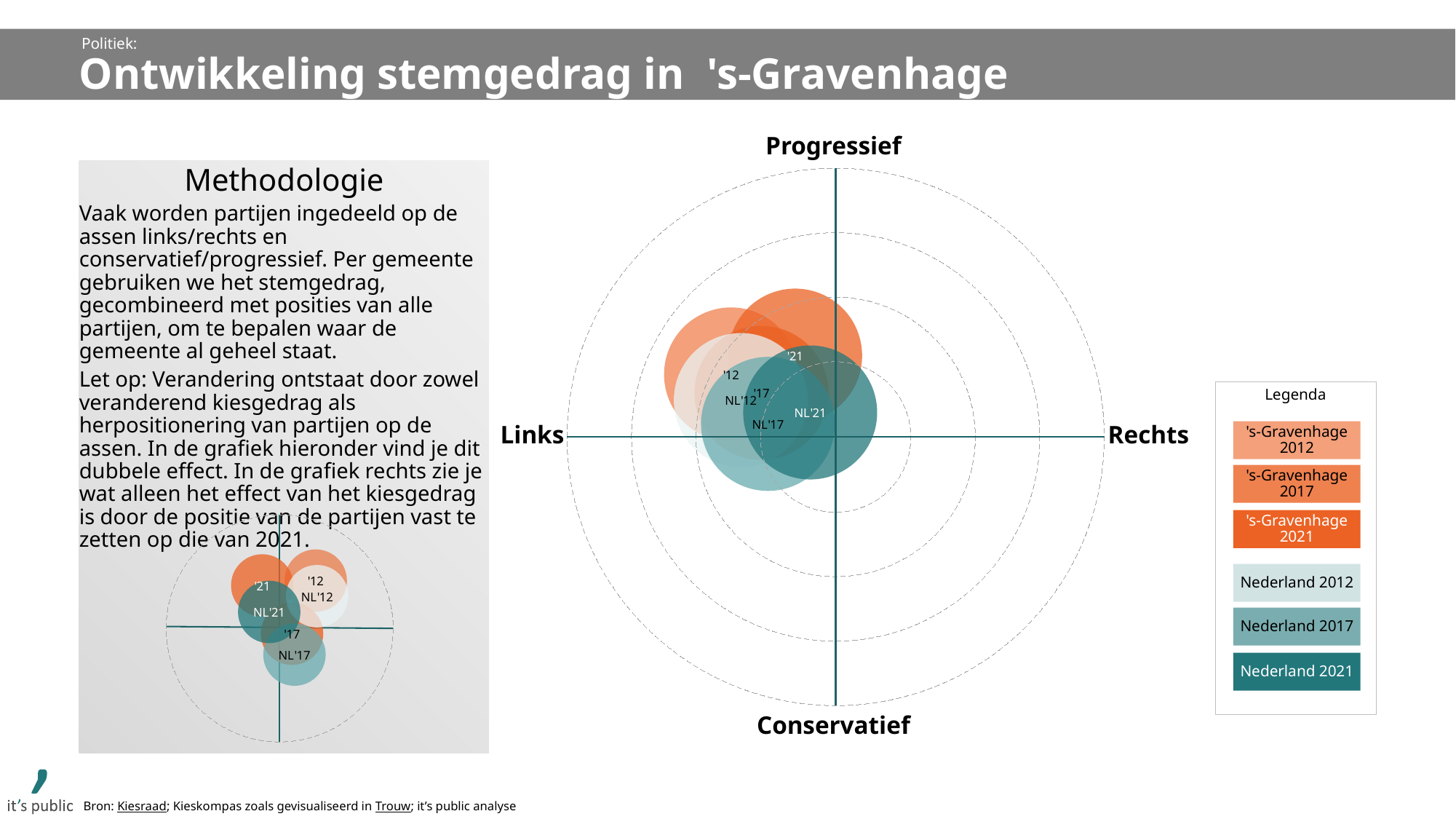
In the large chart, do the 's-Gravenhage bubbles move toward Links or toward Rechts from 2012 to 2021? Rechts What label appears at the right end of the horizontal axis of the large chart? Rechts In the large chart, is the '21 bubble for 's-Gravenhage positioned to the left or to the right of the '12 bubble for 's-Gravenhage? Right In the large chart, is the NL'21 bubble on the Links side or the Rechts side of the vertical axis? Links In the small chart at the bottom left, is the '12 bubble on the Links side or the Rechts side of the vertical axis? Rechts In the large chart, which 's-Gravenhage bubble is positioned highest on the Progressief axis? '21 In the small chart at the bottom left, is the NL'17 bubble above or below the horizontal axis? Below What kind of chart is the large chart in the centre of the slide? Bubble chart What label appears at the top of the vertical axis of the large chart? Progressief How many bubbles are plotted in the large chart? 6 How many entries does the legend list? 6